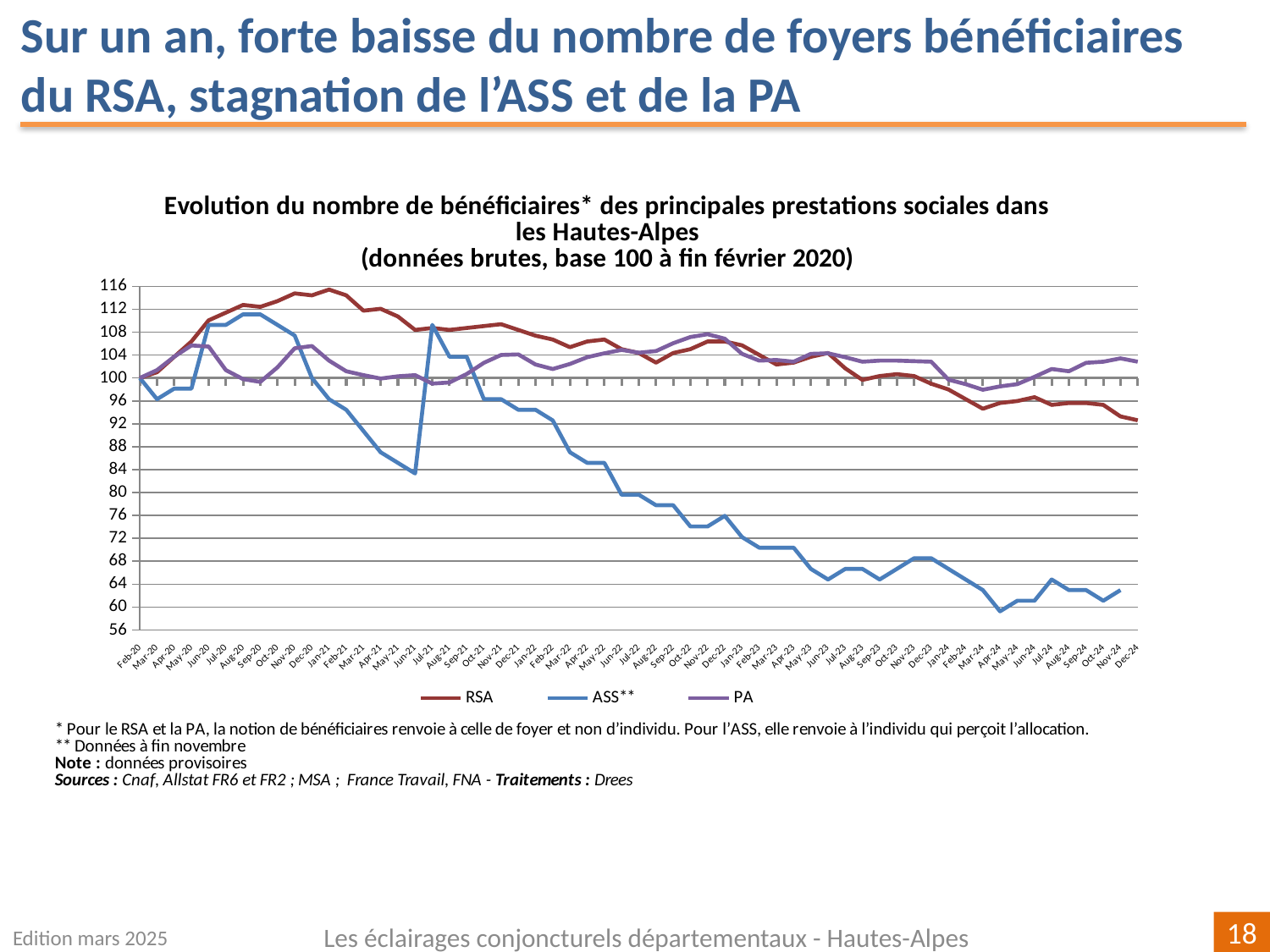
Is the value for ASS** at Nov-24 greater or less than 68? less Is the value for PA at Dec-24 greater or less than 100? greater Is the value for RSA at Feb-21 greater or less than 112? greater Does the ASS** series rise or fall overall between Jul-21 and Nov-24? fall What are the series names listed in the legend? RSA, ASS**, PA How many series does the legend list? 3 What is the value of the RSA series at Feb-20, the base period? 100 Which département does the chart title say the data refer to? Hautes-Alpes At Dec-24, which series has the larger value, RSA or PA? PA What kind of chart is shown on the slide? line chart At Jun-21, which series has the larger value, ASS** or RSA? RSA